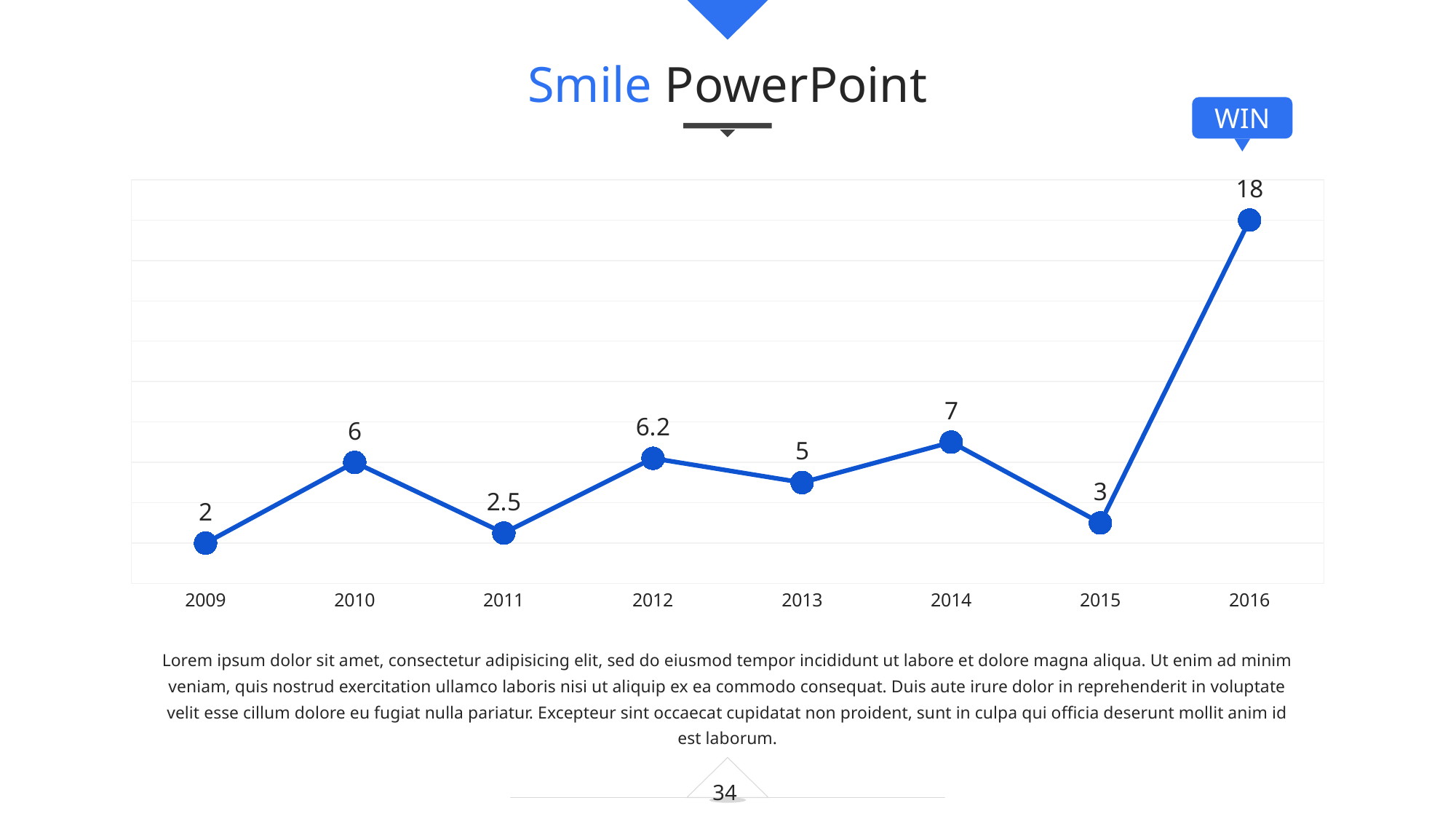
Does the value rise or fall from 2015 to 2016? rise What is the value for 2012? 6.2 What is the value for 2011? 2.5 What is the difference between the values for 2010 and 2011? 3.5 What does the label above the 2016 data point say? WIN What kind of chart is shown on the slide? line chart Which year has the lowest value? 2009 Which is larger, the value for 2014 or the value for 2013? 2014 What is the value for 2016? 18 What is the difference between the values for 2016 and 2015? 15 Which year has the highest value? 2016 How many years are plotted on the x axis? 8